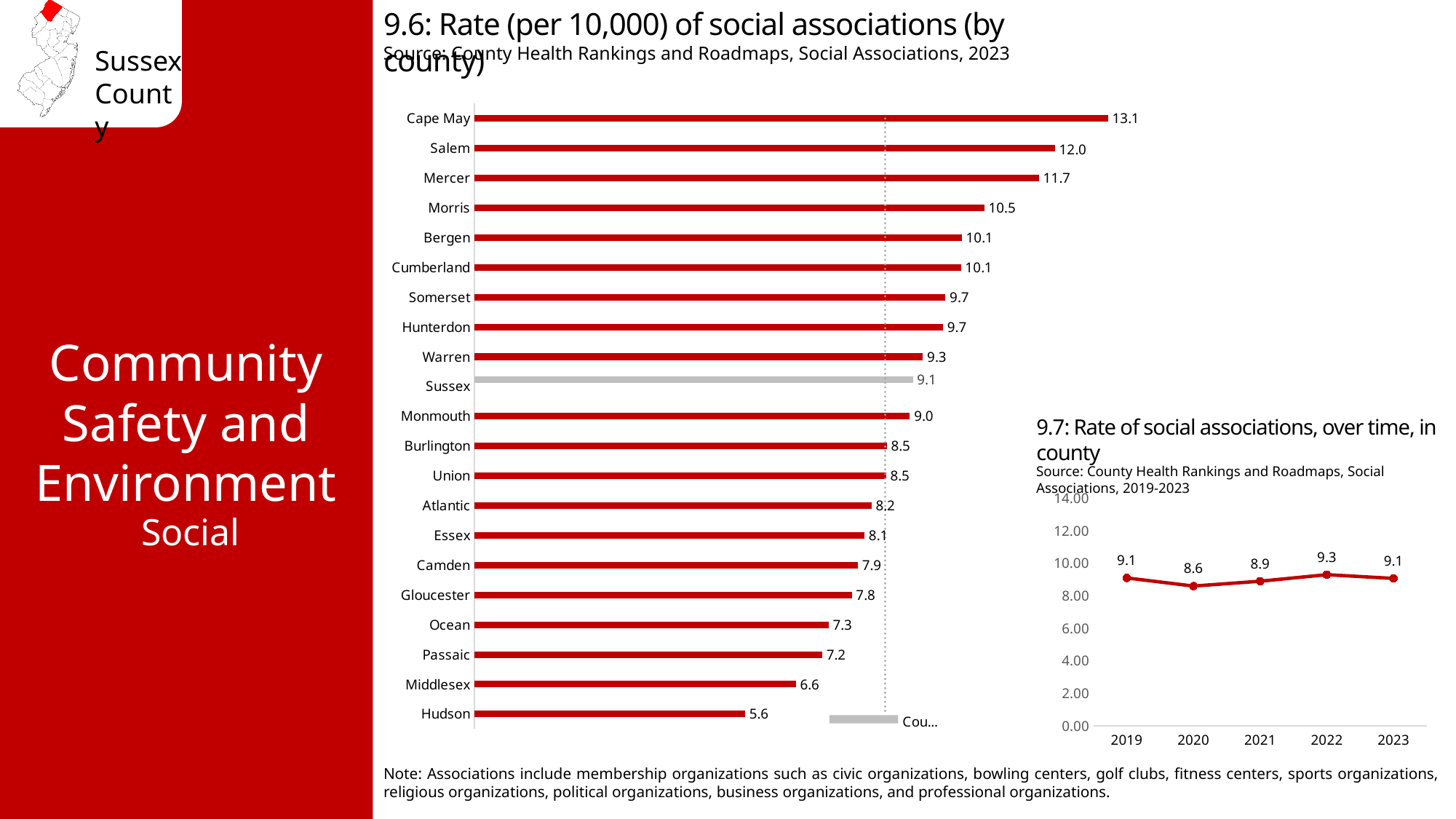
In the chart '9.6: Rate (per 10,000) of social associations (by county)', what is the value for Sussex? 9.1 In the chart '9.6: Rate (per 10,000) of social associations (by county)', which has a higher value, Morris or Warren? Morris In the chart '9.7: Rate of social associations, over time, in county', how many years are plotted? 5 In the chart '9.6: Rate (per 10,000) of social associations (by county)', which county has the highest rate? Cape May What kind of chart is '9.6: Rate (per 10,000) of social associations (by county)'? Bar chart In the chart '9.6: Rate (per 10,000) of social associations (by county)', what is the value for Middlesex? 6.6 In the chart '9.6: Rate (per 10,000) of social associations (by county)', what is the difference between the values for Cape May and Hudson? 7.5 What kind of chart is '9.7: Rate of social associations, over time, in county'? Line chart In the chart '9.6: Rate (per 10,000) of social associations (by county)', how many counties are shown? 21 In the chart '9.7: Rate of social associations, over time, in county', which year has the highest value? 2022 In the chart '9.6: Rate (per 10,000) of social associations (by county)', which county has the lowest rate? Hudson In the chart '9.7: Rate of social associations, over time, in county', what is the value for 2020? 8.6